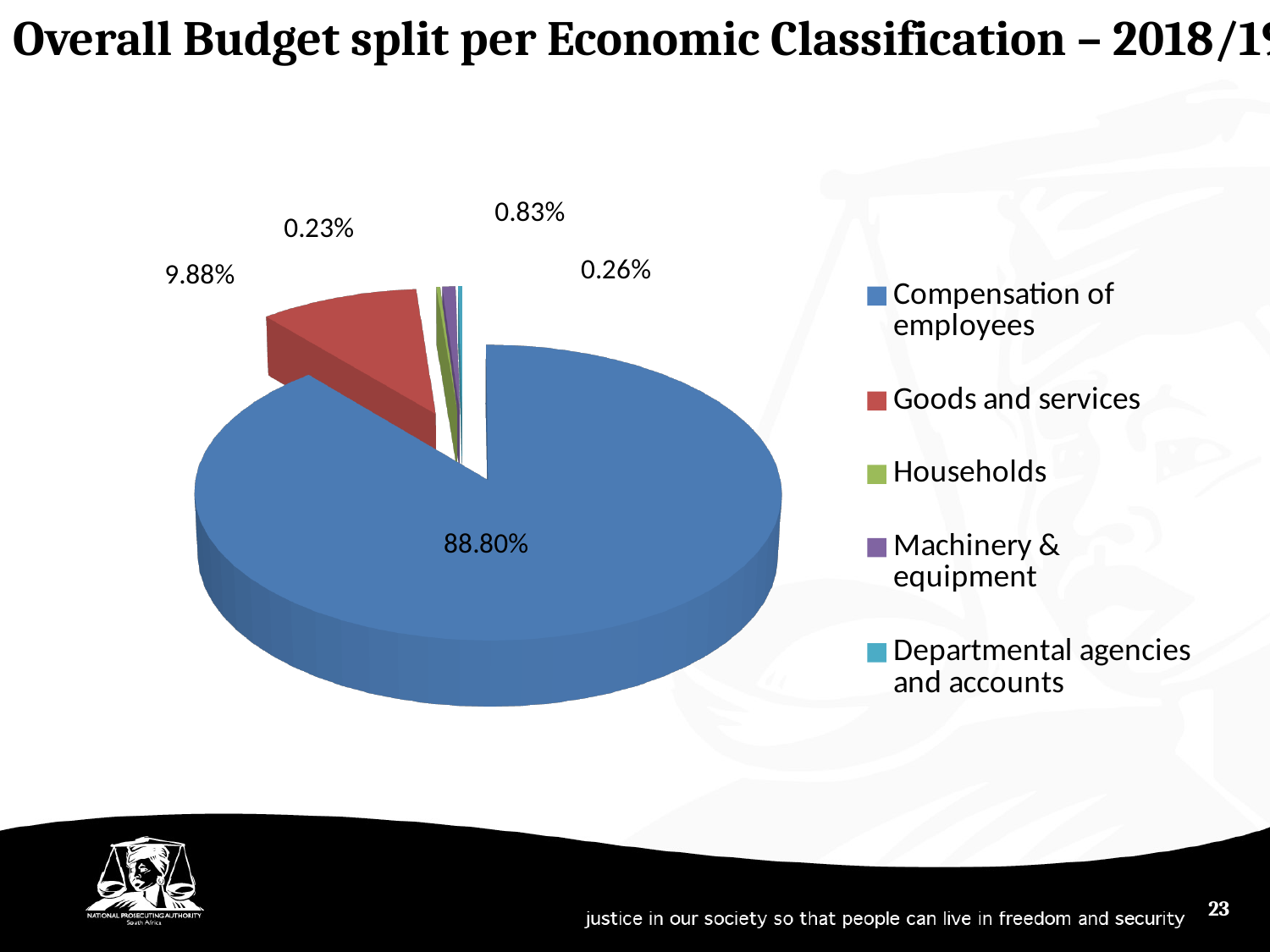
How many entries does the legend list? 5 Which economic classification has the largest share of the budget? Compensation of employees What is the combined share of the three smallest slices (0.23%, 0.83% and 0.26%)? 1.32% Which is larger, the share for Compensation of employees or the share for Goods and services? Compensation of employees What is the smallest percentage label shown on the pie chart? 0.23% How many slices does the pie chart have? 5 What kind of chart is shown on the slide? Pie chart What colour represents Goods and services in the pie chart? Red Is the share for Compensation of employees greater or less than 50%? greater What share of the budget goes to Goods and services? 9.88% What is the difference in percentage points between Compensation of employees and Goods and services? 78.92% What share of the budget goes to Compensation of employees? 88.80%